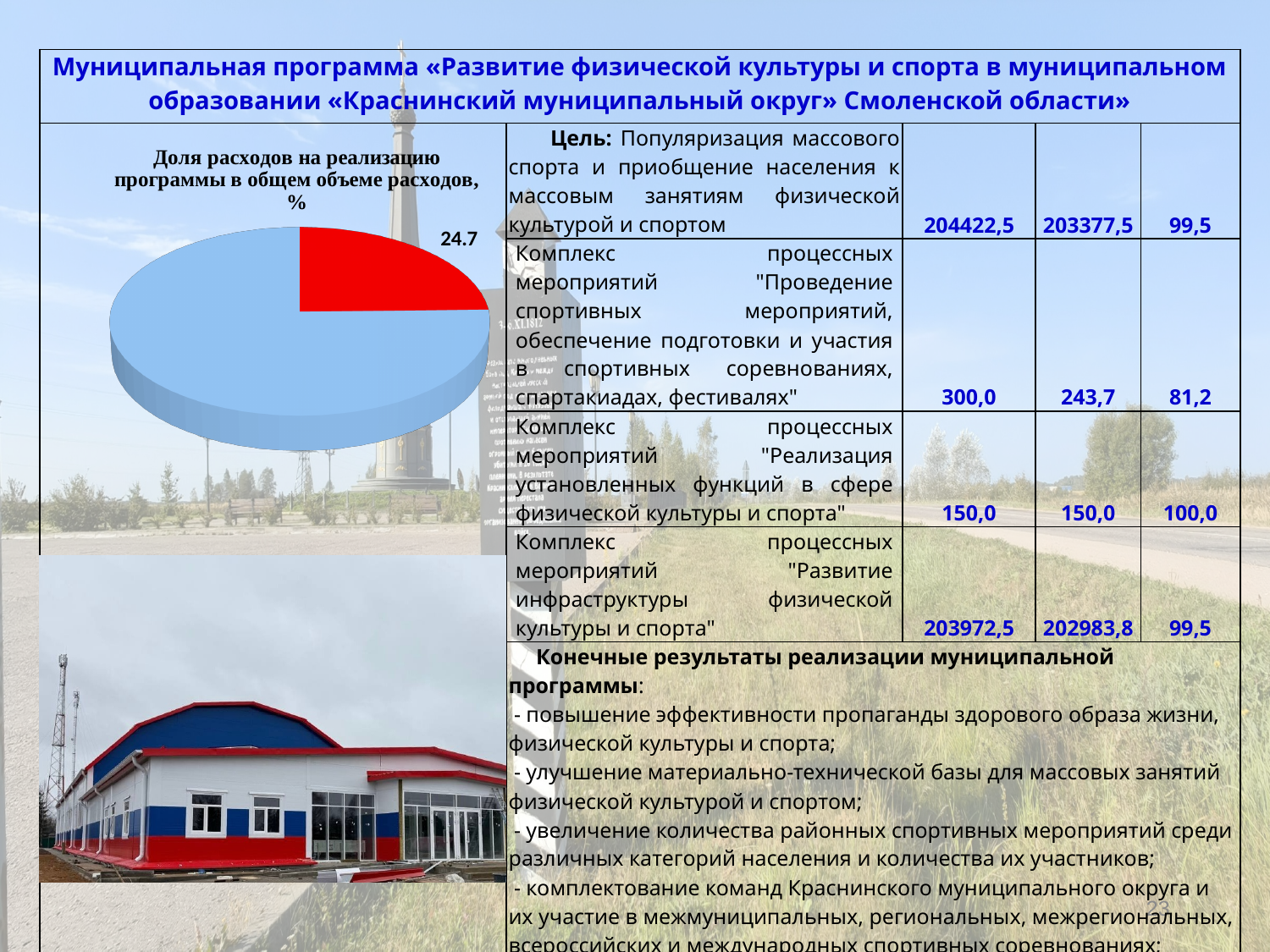
What is the title of the pie chart on the slide? Доля расходов на реализацию программы в общем объеме расходов, % What share of the pie does the red slice represent, according to the data label? 24.7 How many slices does the pie chart have? 2 What kind of chart is shown on the left of the slide? pie chart Which slice of the pie chart is larger, the red one or the blue one? the blue one What colour is the slice of the pie chart labelled 24.7? red What value is printed on the labelled slice of the pie chart? 24.7 Which slice of the pie chart is the smallest? the red slice (24.7)